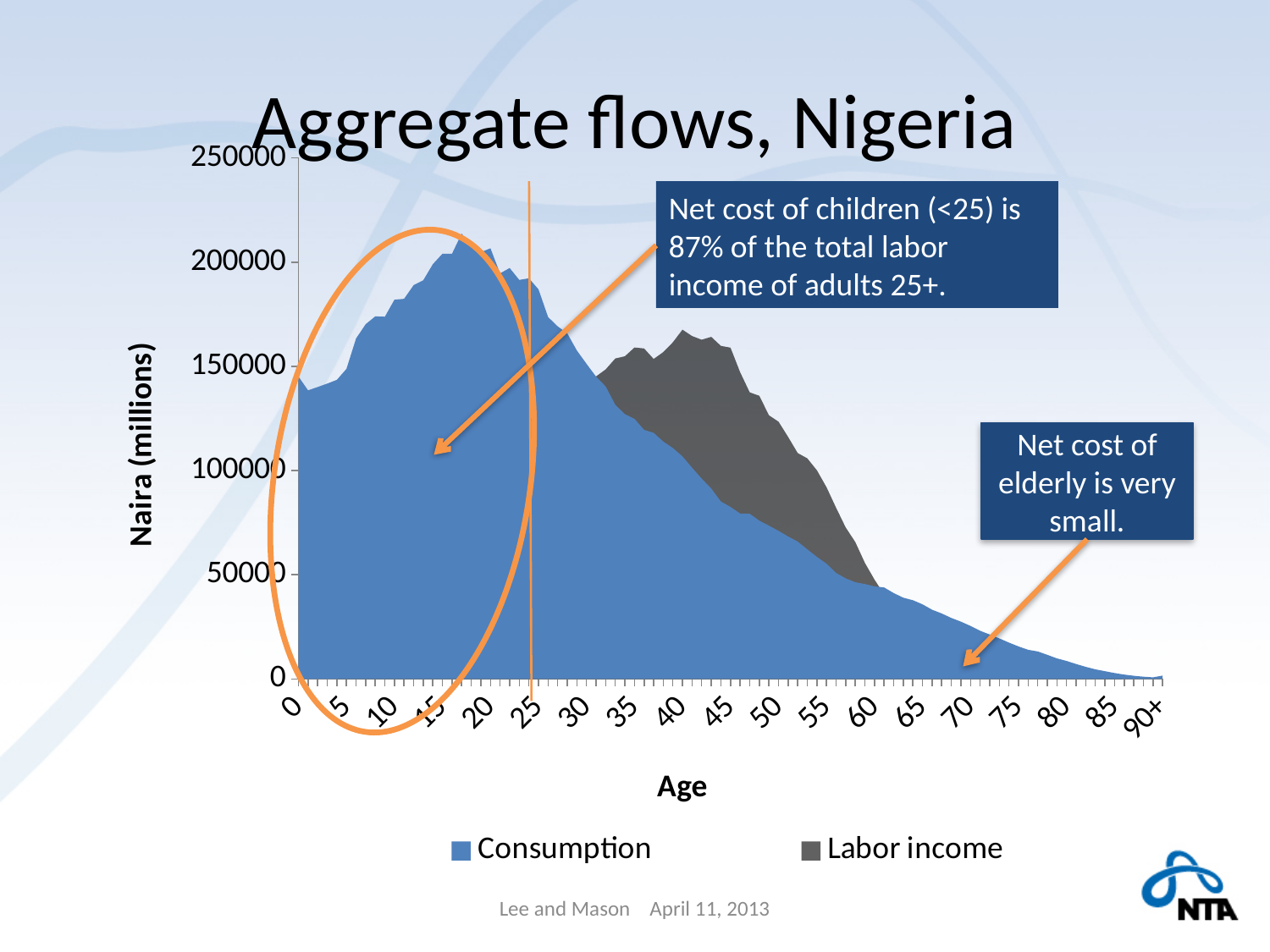
Is the Labor income value at age 40 greater or less than 100000? greater Is the Consumption value at age 85 greater or less than 50000? less What is the label on the vertical axis? Naira (millions) Is the Consumption value at age 0 greater or less than 100000? greater What kind of chart is shown on the slide? area chart Does Consumption rise or fall as age increases from 60 to 90+? fall At age 10, which is larger, Consumption or Labor income? Consumption How many series does the legend list? 2 At age 45, which is larger, Consumption or Labor income? Labor income What are the two series named in the legend? Consumption and Labor income